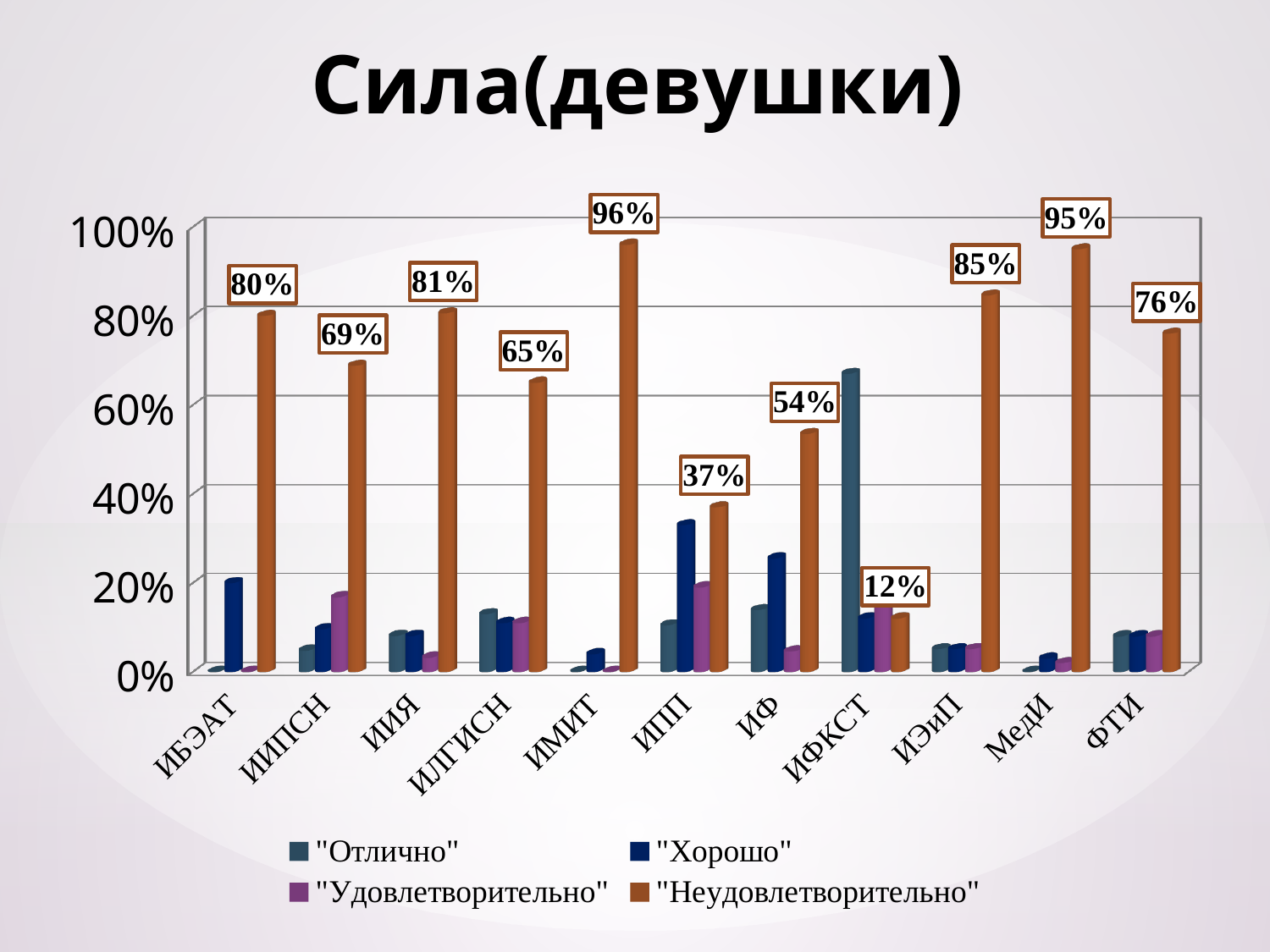
Is the "Отлично" value for ИФКСТ greater or less than 60%? greater Which is larger, the "Неудовлетворительно" value for ИЭиП or for ИЛГИСН? ИЭиП What is the value for "Неудовлетворительно" for ИМИТ? 96% What is the value for "Неудовлетворительно" for ИФКСТ? 12% What is the value for "Неудовлетворительно" for ИИПСН? 69% Is the "Хорошо" value for ИПП greater or less than 40%? less How many categories are shown on the x axis? 11 What is the difference between the "Неудовлетворительно" values for МедИ and ФТИ? 19% What type of chart is shown on the slide? Bar chart Which category has the highest "Неудовлетворительно" value? ИМИТ How many series does the legend list? 4 Which category has the lowest "Неудовлетворительно" value? ИФКСТ